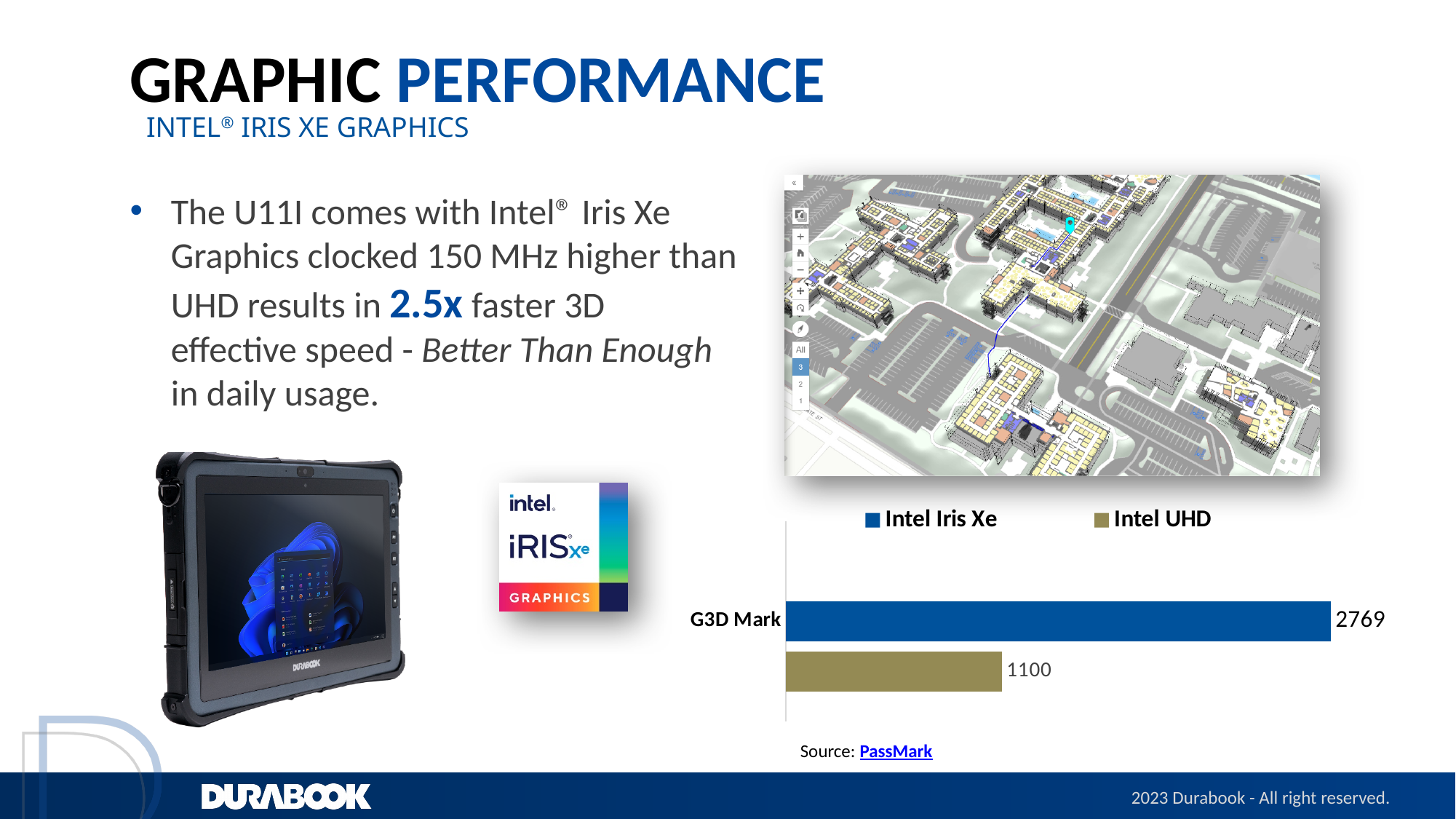
What is the G3D Mark value for Intel UHD? 1100 What is the difference between the Intel Iris Xe and Intel UHD G3D Mark scores? 1669 How many series does the chart legend list? 2 What is the G3D Mark value for Intel Iris Xe? 2769 What kind of chart is shown on the slide? bar chart Which series has the higher G3D Mark score? Intel Iris Xe Which series has the lower G3D Mark score? Intel UHD What source is cited below the chart? PassMark What is the name of the category shown on the chart? G3D Mark How many categories are shown on the chart's category axis? 1 Is the G3D Mark score for Intel UHD larger or smaller than the score for Intel Iris Xe? smaller